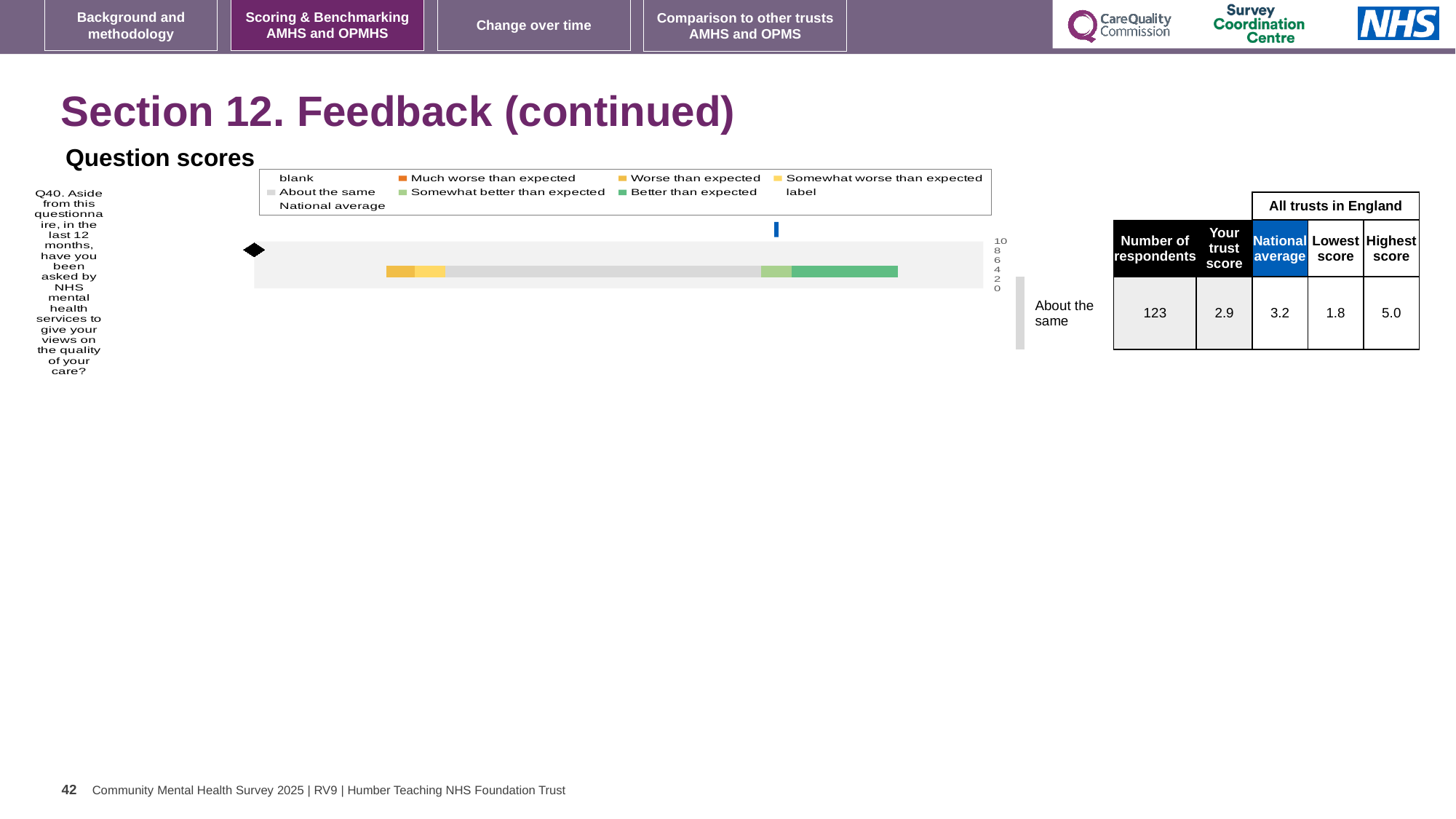
What kind of chart is used to show the Q40 question score? bar chart Which legend entry in the Question scores chart is shown in grey? About the same How many respondents answered Q40? 123 How many questions are plotted in the Question scores chart? 1 What is the national average score for Q40 shown next to the chart? 3.2 Is the trust's Q40 score higher or lower than the national average? lower What is the difference between the highest and lowest trust scores for Q40? 3.2 What is the trust's score for Q40 shown next to the chart? 2.9 What is the lowest score among all trusts in England for Q40? 1.8 Which legend entry in the Question scores chart is shown in dark green? Better than expected Which benchmark category is the trust's Q40 score placed in? About the same What is the highest score among all trusts in England for Q40? 5.0